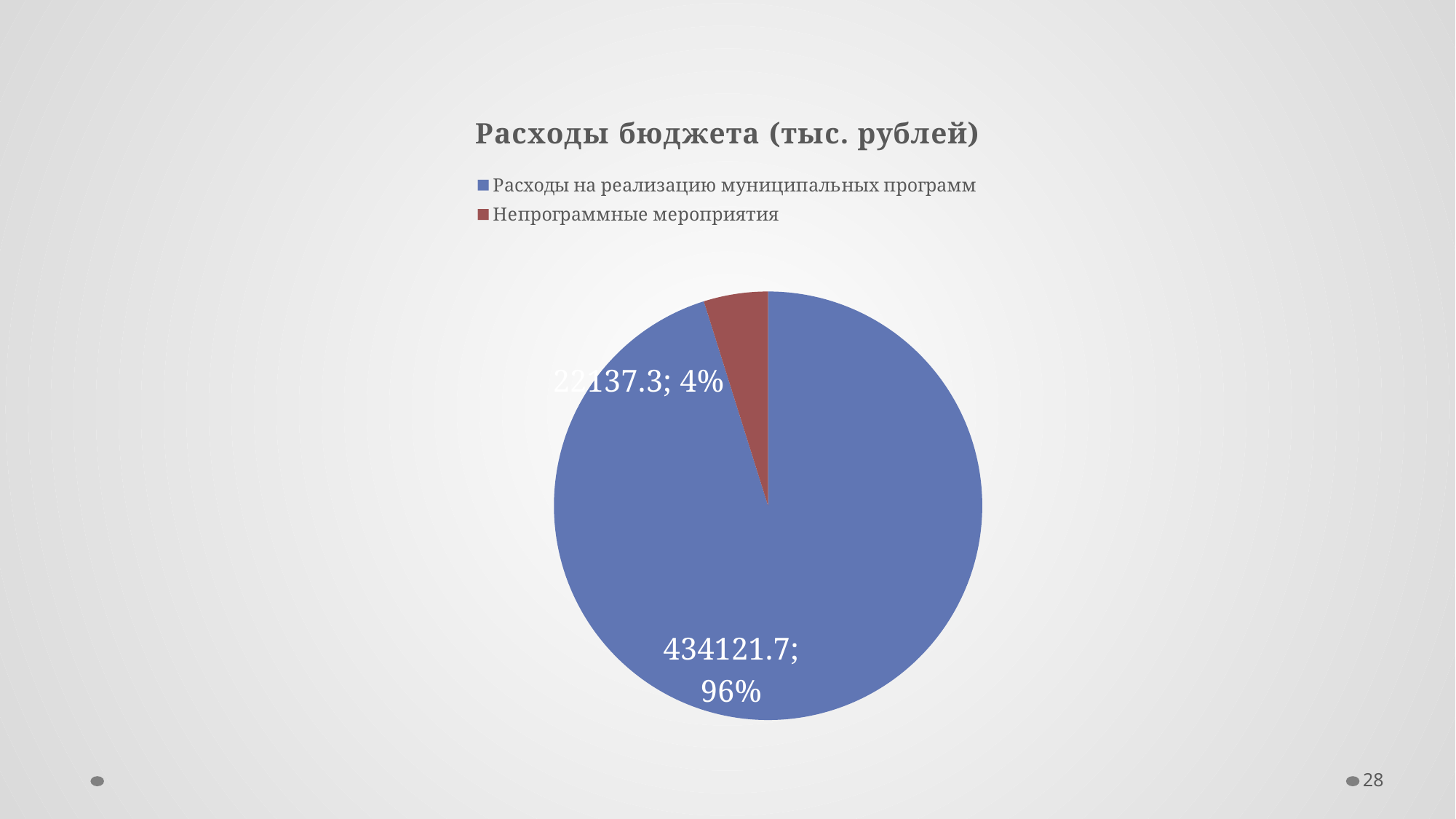
How many slices does the pie chart have? 2 What is the value for Непрограммные мероприятия? 22137.3 Which category has the smallest slice? Непрограммные мероприятия What share of the pie does Расходы на реализацию муниципальных программ represent? 96% What share of the pie does Непрограммные мероприятия represent? 4% What is the value for Расходы на реализацию муниципальных программ? 434121.7 Which category has the largest slice? Расходы на реализацию муниципальных программ What type of chart is shown on the slide? pie chart What is the difference between the values for Расходы на реализацию муниципальных программ and Непрограммные мероприятия? 411984.4 What is the title of the chart? Расходы бюджета (тыс. рублей) How many entries does the legend list? 2 What colour is the slice for Непрограммные мероприятия? red